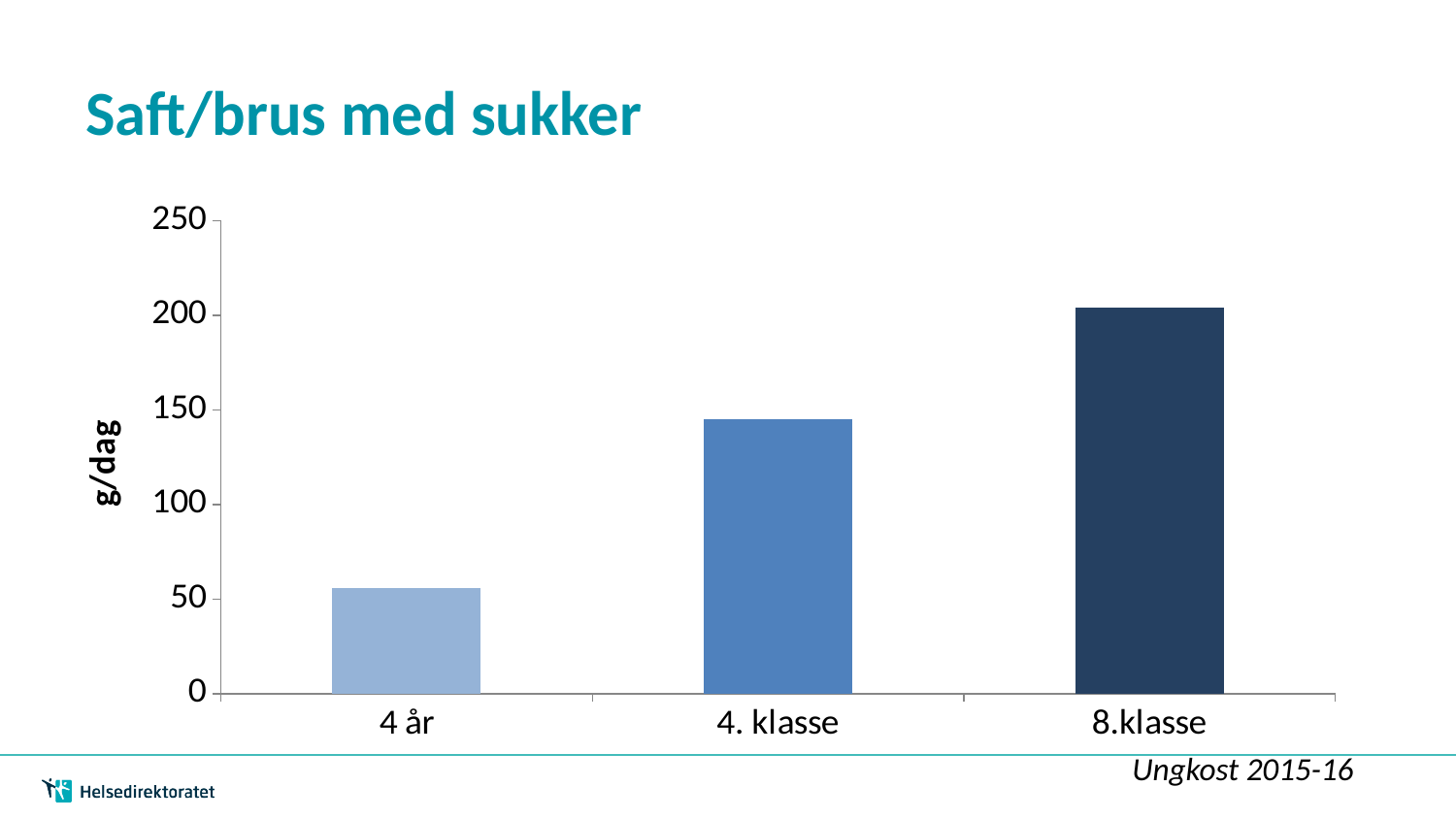
Which category has the lowest value in the chart? 4 år Is the value for 8.klasse greater or less than 150? greater What is the label on the vertical axis of the chart? g/dag Is the value for 4 år greater or less than 100? less Do the values rise or fall from 4 år to 8.klasse along the x axis? rise Which category has the highest value in the chart? 8.klasse Is the value for 4. klasse greater or less than 100? greater How many categories are shown on the x axis of the chart? 3 Which is larger, the value for 4. klasse or the value for 8.klasse? 8.klasse What is the title of the chart? Saft/brus med sukker What kind of chart is shown on the slide? bar chart Which is larger, the value for 4 år or the value for 4. klasse? 4. klasse